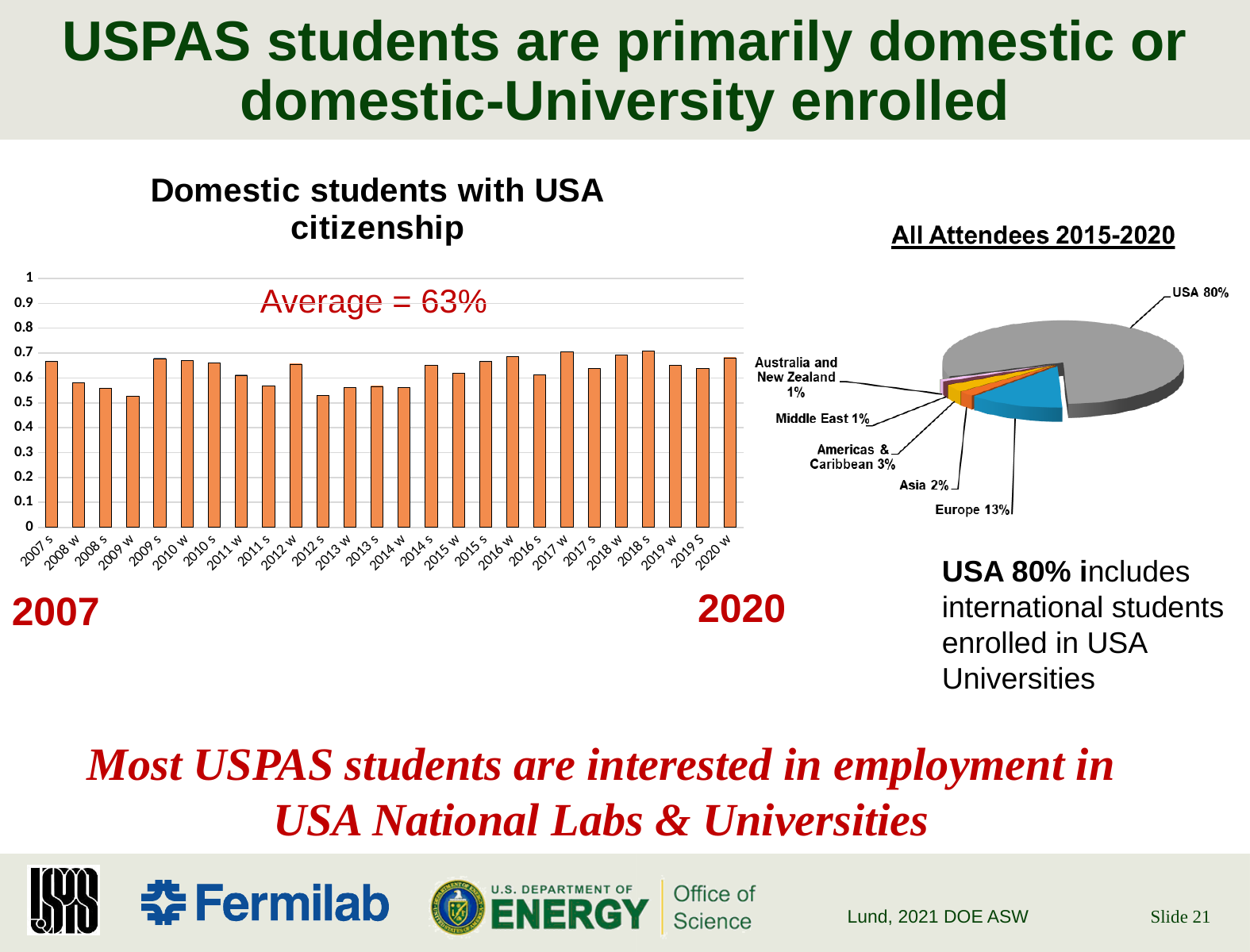
What kind of chart is 'Domestic students with USA citizenship'? Bar chart In the pie chart 'All Attendees 2015-2020', what share of attendees is from Americas & Caribbean? 3% In the pie chart 'All Attendees 2015-2020', what share of attendees is from the USA? 80% In the pie chart 'All Attendees 2015-2020', what is the difference in percentage points between the USA share and the Europe share? 67 In the pie chart 'All Attendees 2015-2020', which is larger, the share for Europe or the share for Asia? Europe In the bar chart 'Domestic students with USA citizenship', is the value for 2009 w greater or less than 0.6? less In the pie chart 'All Attendees 2015-2020', what share of attendees is from Europe? 13% How many slices does the pie chart 'All Attendees 2015-2020' have? 6 In the pie chart 'All Attendees 2015-2020', which region has the largest share? USA In the bar chart 'Domestic students with USA citizenship', is the value for 2017 w greater or less than 0.6? greater How many bars are shown in the bar chart 'Domestic students with USA citizenship'? 26 In the pie chart 'All Attendees 2015-2020', what share of attendees is from Asia? 2%